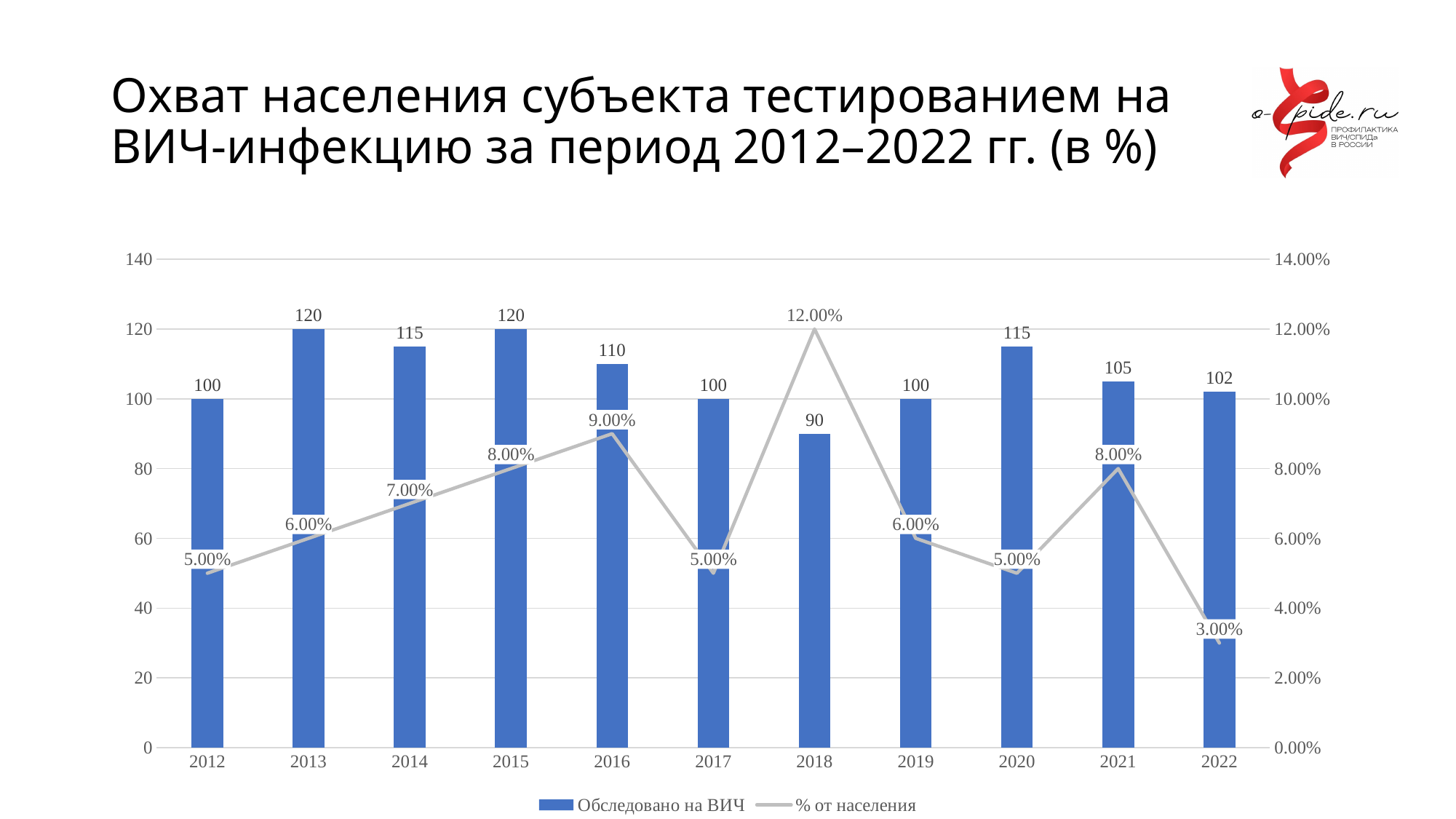
How many years are shown on the x axis? 11 Which year has the lowest "% от населения" value? 2022 What is the difference between the "Обследовано на ВИЧ" values for 2013 and 2012? 20 How many series does the legend list? 2 Does the "% от населения" line rise or fall from 2012 to 2016? Rise Which is larger, the "Обследовано на ВИЧ" value for 2020 or for 2021? 2020 What kinds of chart are combined on this slide? Bar chart and line chart What colour are the "Обследовано на ВИЧ" bars? Blue What is the value of "Обследовано на ВИЧ" for 2018? 90 Which year has the lowest "Обследовано на ВИЧ" value? 2018 What is the "% от населения" value for 2016? 9.00% Which year has the highest "% от населения" value? 2018